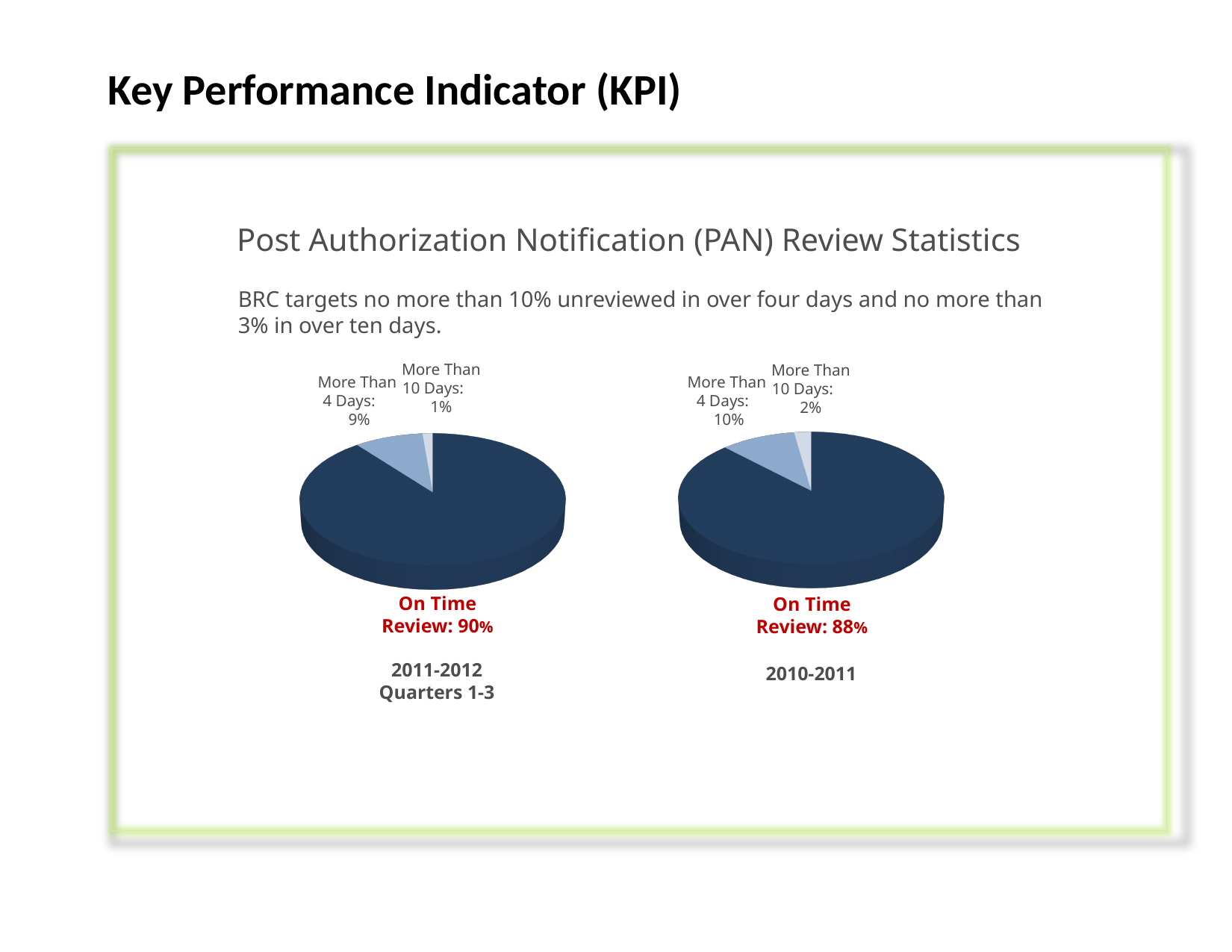
In the 2011-2012 Quarters 1-3 pie chart, which slice is the largest? On Time Review How many slices does the 2011-2012 Quarters 1-3 pie chart have? 3 What is the difference between the On Time Review share in 2011-2012 Quarters 1-3 and in 2010-2011? 2% In the 2010-2011 pie chart, what percentage took More Than 4 Days? 10% What type of chart is used for the 2010-2011 data? Pie chart What is the title shown above the two pie charts? Post Authorization Notification (PAN) Review Statistics In the 2010-2011 pie chart, what share of reviews were On Time? 88% In the 2011-2012 Quarters 1-3 pie chart, what share of reviews were On Time? 90% In the 2010-2011 pie chart, what percentage took More Than 10 Days? 2% In the 2010-2011 pie chart, which slice is the smallest? More Than 10 Days Which period has the larger More Than 4 Days share, 2011-2012 Quarters 1-3 or 2010-2011? 2010-2011 In the 2011-2012 Quarters 1-3 pie chart, what percentage took More Than 4 Days? 9%